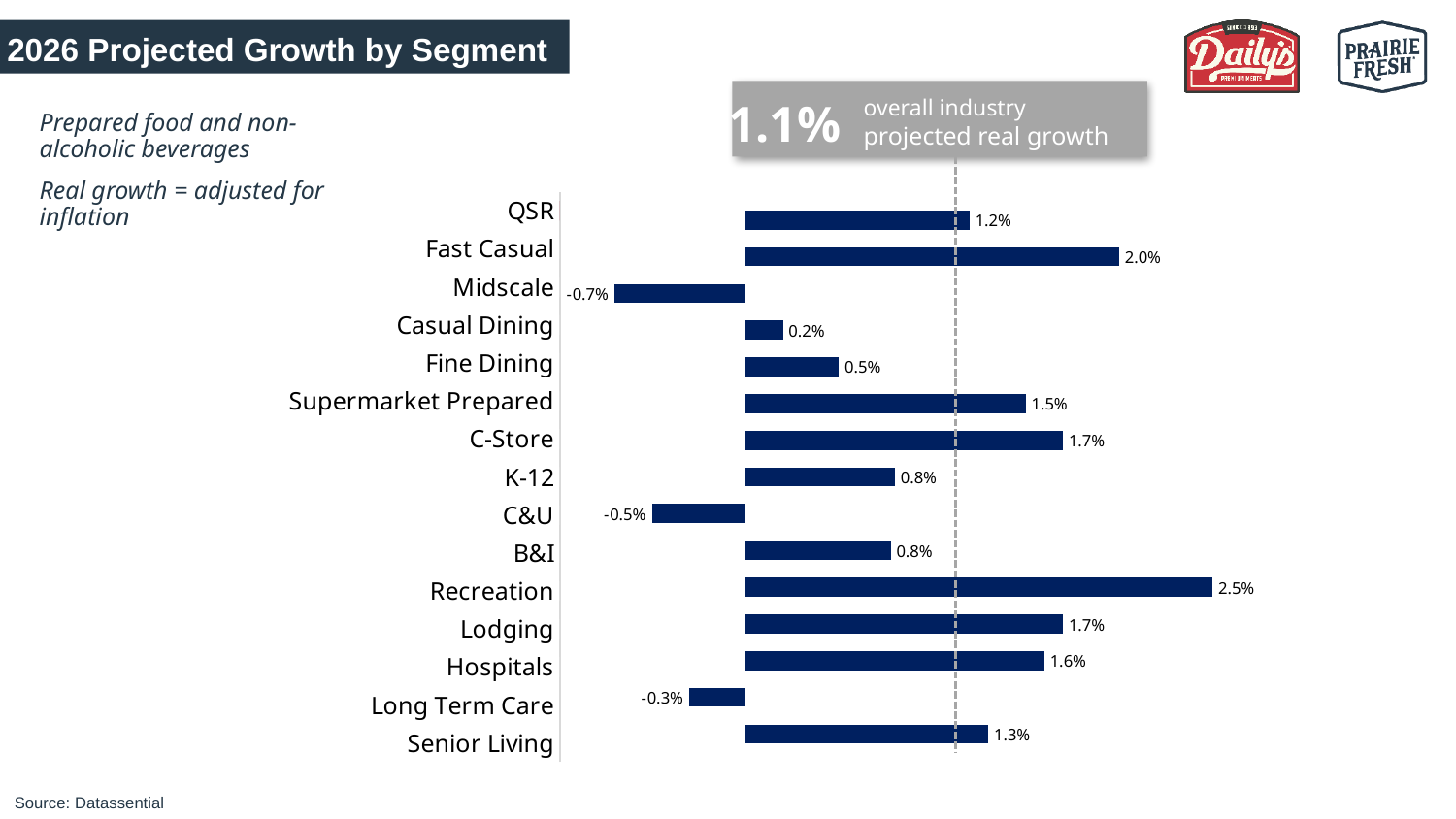
What kind of chart is used to show projected growth by segment? Bar chart What is the source cited for the chart data? Datassential What is the difference between the projected growth for Fast Casual and QSR? 0.8 percentage points What value is shown for Long Term Care? -0.3% Which segment has the highest projected growth? Recreation How many segments are shown in the chart? 15 What is the 2026 projected real growth for Fast Casual? 2.0% What is the projected growth for Supermarket Prepared? 1.5% What is the projected growth value shown for Midscale? -0.7% Which has the higher projected growth, C-Store or Hospitals? C-Store Which segment has the lowest projected growth? Midscale What overall industry projected real growth rate does the dashed line represent? 1.1%